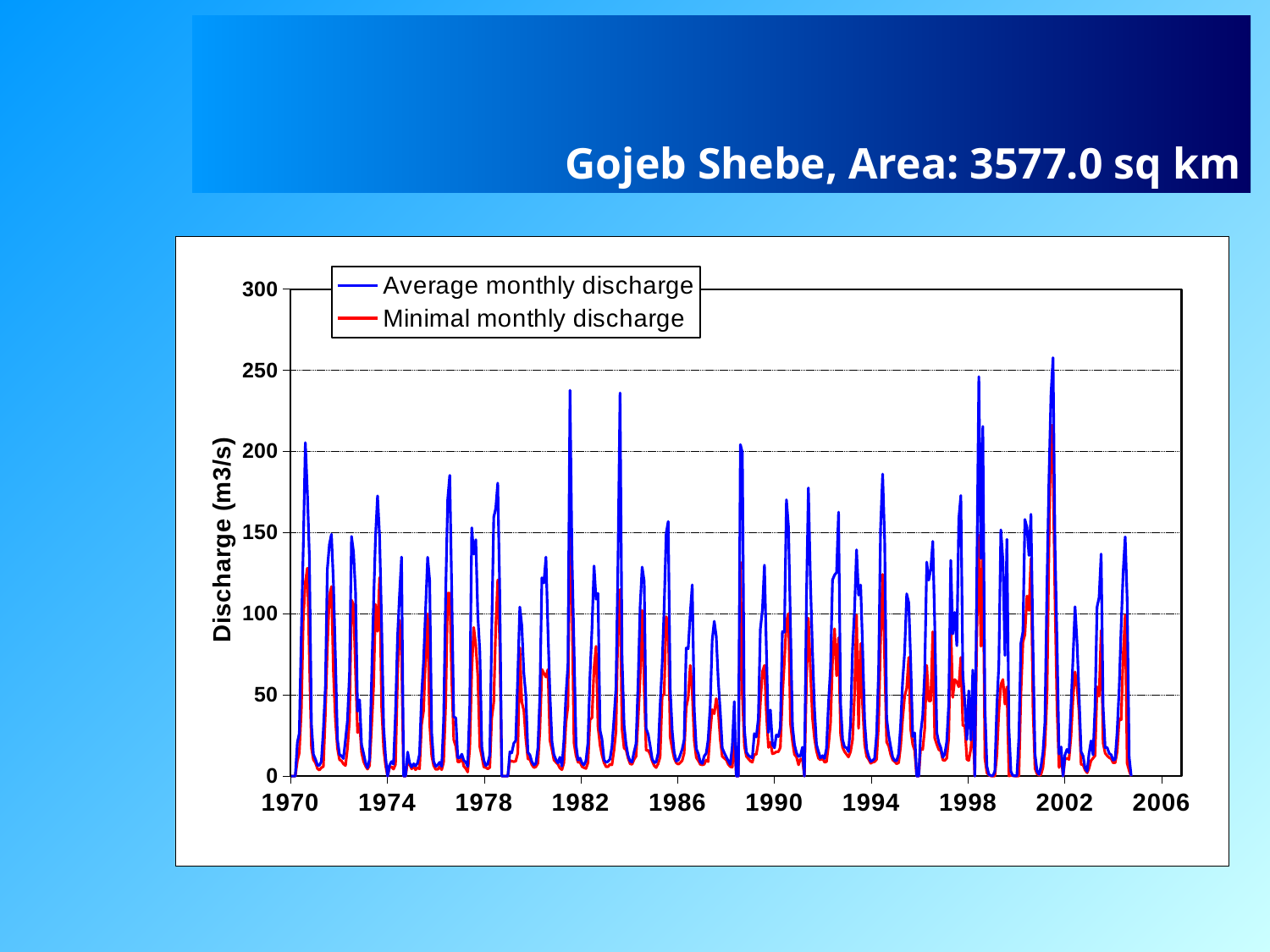
Which series generally has the higher values, Average monthly discharge or Minimal monthly discharge? Average monthly discharge Around which year does the Average monthly discharge series reach its highest peak? 2001 Is the peak of the Average monthly discharge series just after 1998 greater or less than 200? greater What is the label of the y axis? Discharge (m3/s) Is the peak of the Average monthly discharge series just before 1982 greater or less than 200? greater Is the highest peak of the Minimal monthly discharge series greater or less than 250? less What kind of chart is shown on the slide? line chart What are the two series named in the legend? Average monthly discharge; Minimal monthly discharge How many series does the legend list? 2